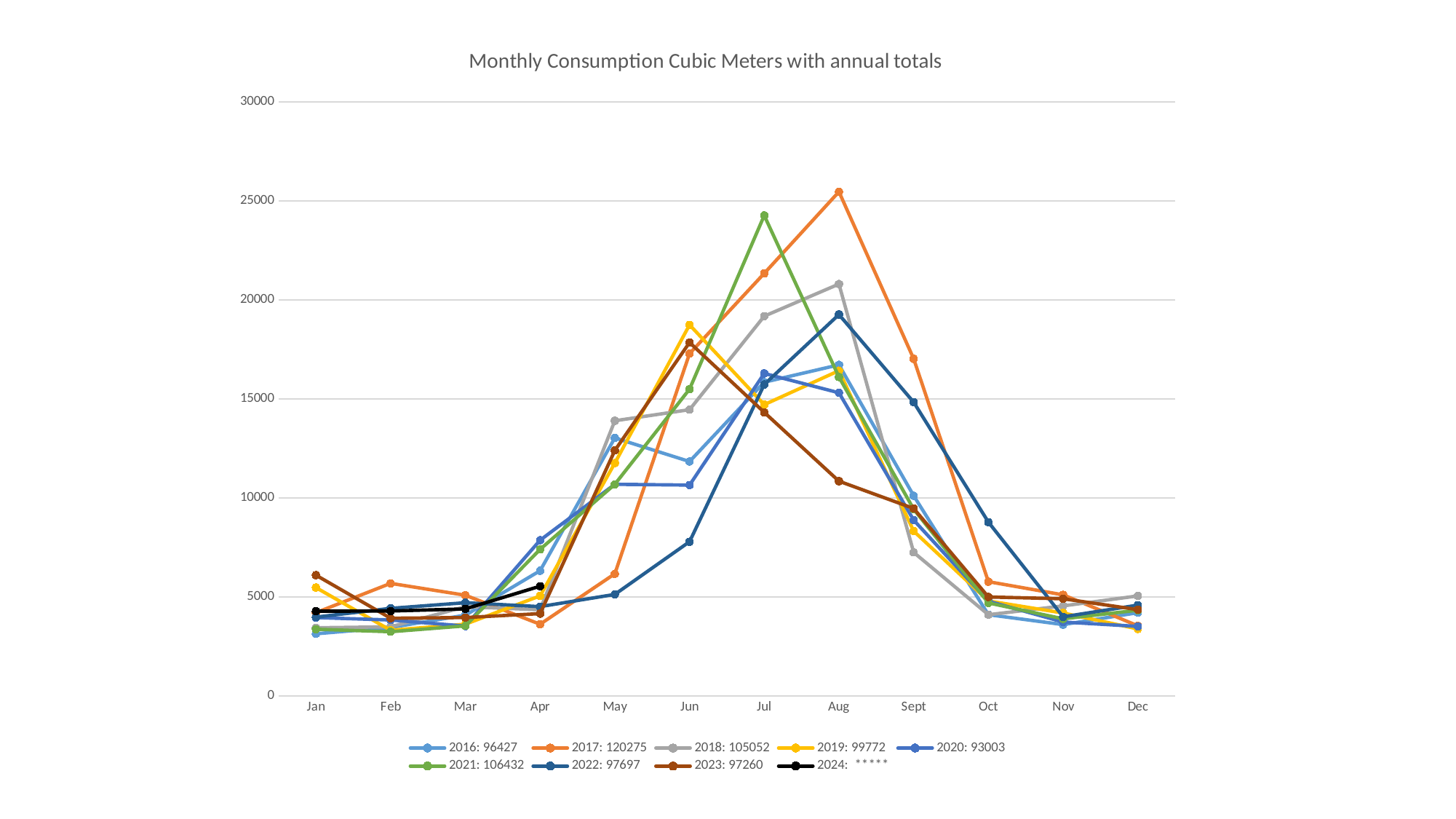
What kind of chart is shown on the slide? line chart Which year has the larger annual total, 2018 or 2021? 2021 Is the value for 2022 in Jun greater or less than 10000? less Is the value for 2017 in Aug greater or less than 25000? greater Which year has the lowest annual total in the legend? 2020 What is the difference between the annual totals for 2017 and 2020? 27272 Which year has the highest annual total in the legend? 2017 What is the annual total shown in the legend for 2017? 120275 What is the title of the chart? Monthly Consumption Cubic Meters with annual totals How many months are shown along the x axis? 12 What is the annual total shown in the legend for 2020? 93003 How many series does the legend list? 9